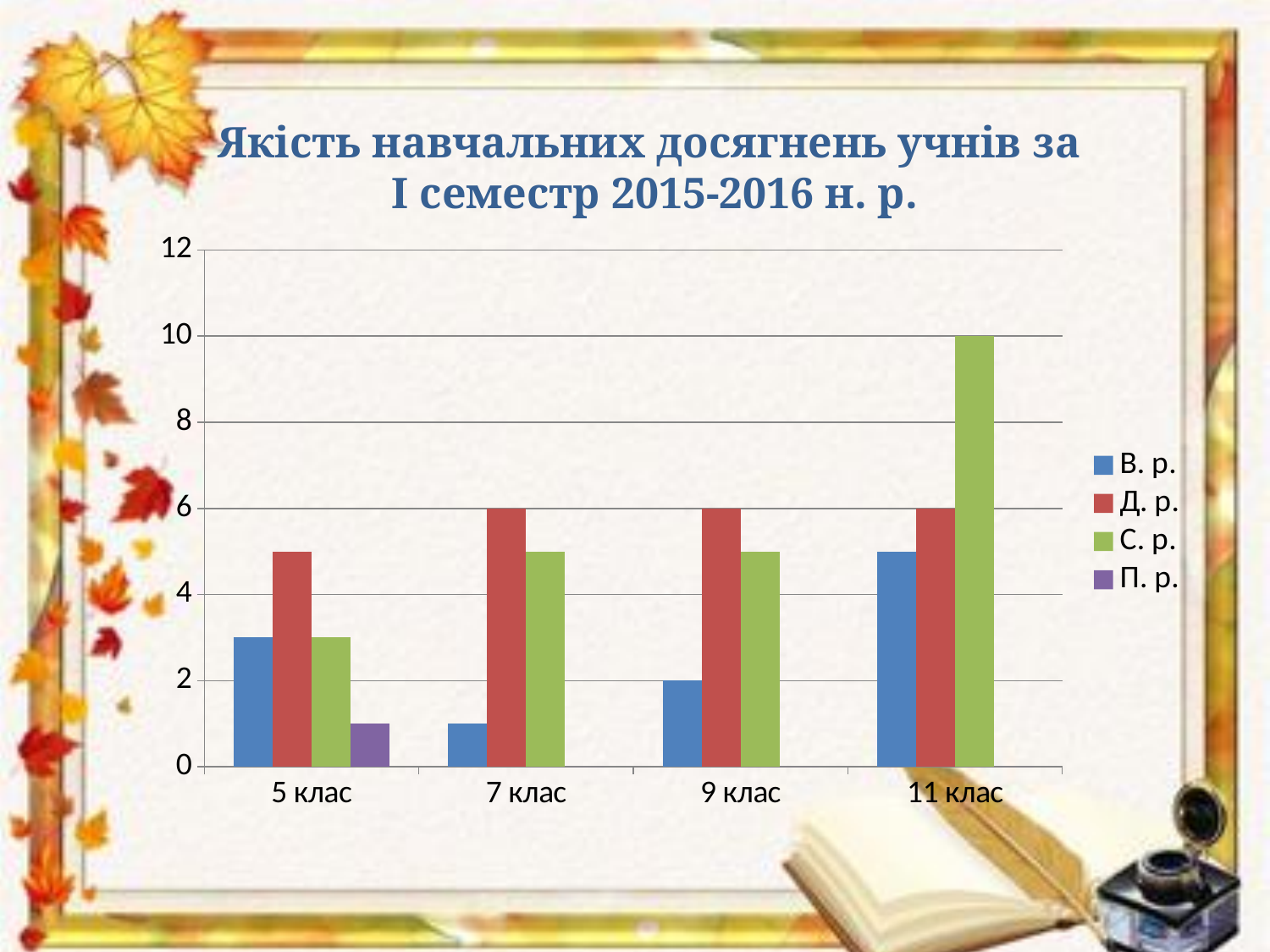
What is the value of Д. р. for 7 клас? 6 Which is larger for 11 клас: В. р. or С. р.? С. р. Is the value of Д. р. for 5 клас greater or less than 4? greater What is the value of С. р. for 11 клас? 10 Which series is shown in purple in the legend? П. р. How many class categories are shown on the x axis? 4 What kind of chart is shown on the slide? bar chart How many series does the legend list? 4 Is the value of В. р. for 7 клас greater or less than 2? less Which class has the lowest В. р. value? 7 клас What is the value of В. р. for 9 клас? 2 Which class has the highest С. р. value? 11 клас